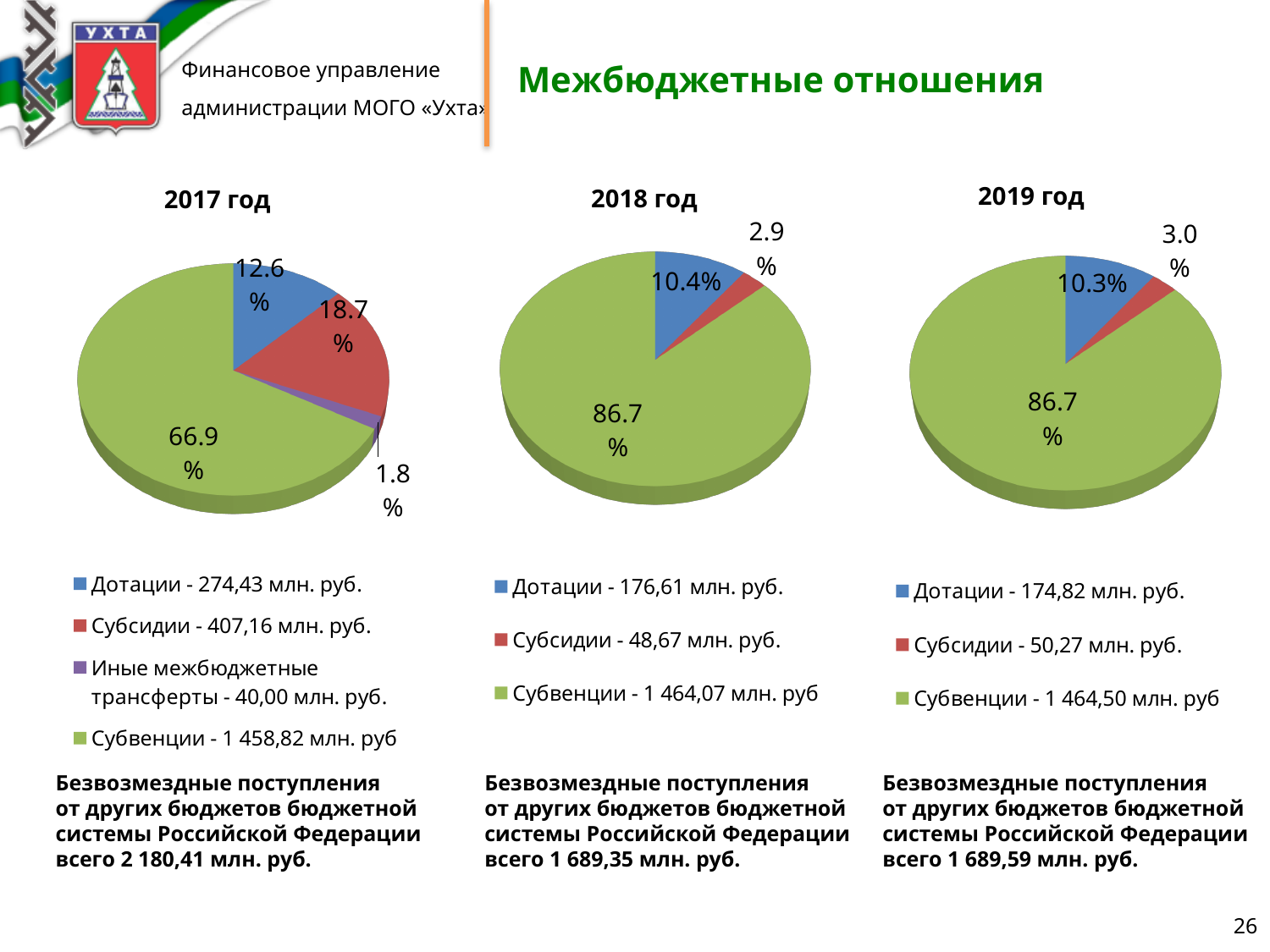
What type of chart is used for the 2018 год data? Pie chart In the 2019 год chart, what share of the pie is Субвенции? 86.7% In the 2018 год chart, what share of the pie is Субсидии? 2.9% In the 2017 год chart, which category has the largest slice? Субвенции How many entries does the legend of the 2019 год chart list? 3 In the 2019 год chart, which is larger, the Дотации slice or the Субсидии slice? Дотации In the 2019 год chart, what is the difference in percentage points between the Дотации and Субсидии slices? 7.3 In the 2017 год chart, which category has the smallest slice? Иные межбюджетные трансферты In the 2017 год chart, what share of the pie is Субвенции? 66.9% How many slices does the 2017 год pie chart have? 4